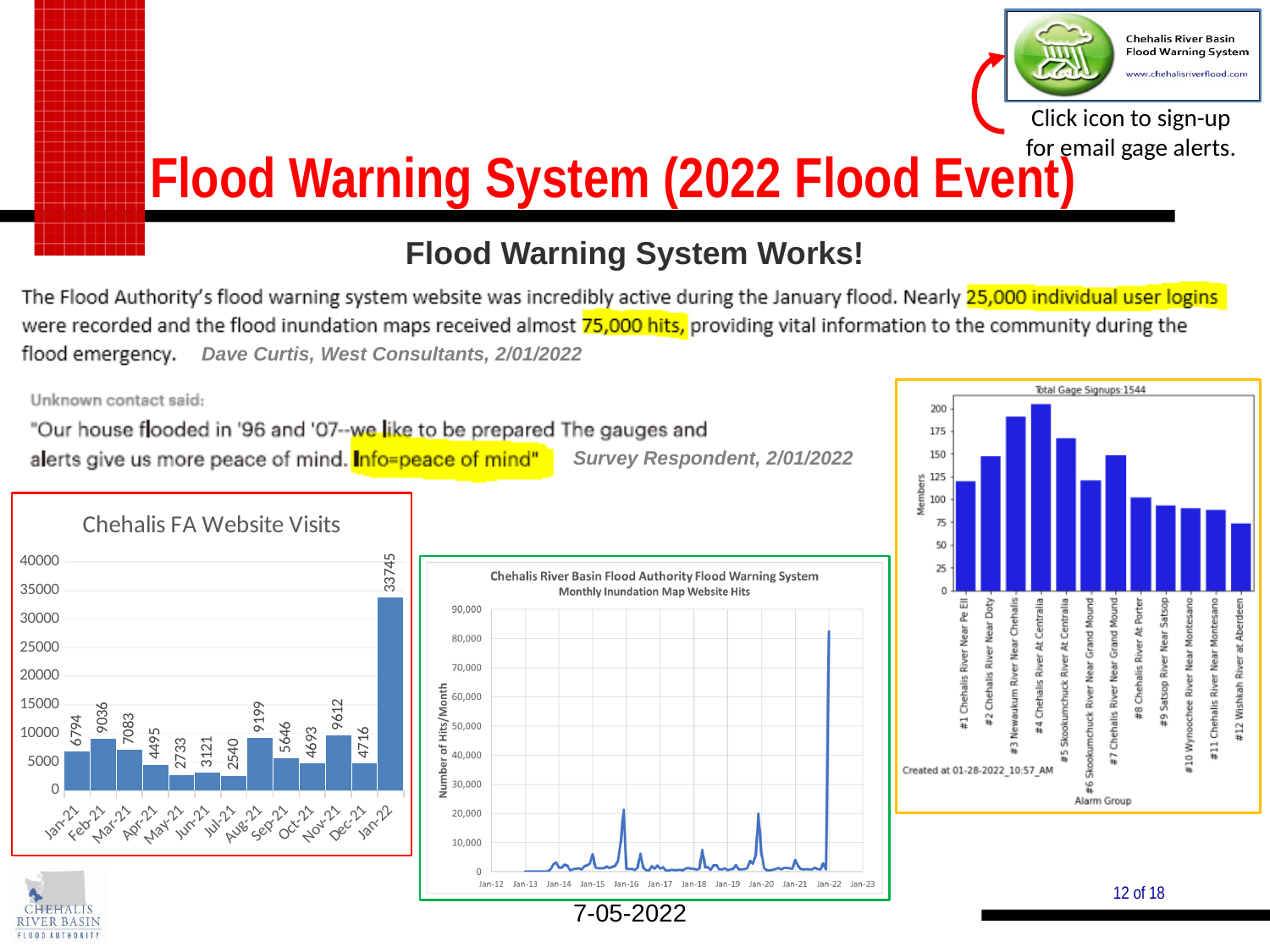
In the 'Chehalis FA Website Visits' chart, which month has the lowest number of visits? Jul-21 In the 'Monthly Inundation Map Website Hits' chart, is the peak value near Jan-22 greater or less than 80,000? greater In the 'Chehalis FA Website Visits' chart, which month has the highest number of visits? Jan-22 In the 'Chehalis FA Website Visits' chart, what is the value for Nov-21? 9612 In the 'Total Gage Signups' chart, which alarm group has the fewest members? #12 Wishkah River at Aberdeen In the 'Chehalis FA Website Visits' chart, what is the difference between the Feb-21 and Jan-21 values? 2242 In the 'Total Gage Signups' chart, is the value for #3 Newaukum River Near Chehalis greater or less than 175? greater How many months are shown in the 'Chehalis FA Website Visits' chart? 13 In the 'Chehalis FA Website Visits' chart, which is larger, the value for Aug-21 or the value for Mar-21? Aug-21 What kind of chart is the 'Monthly Inundation Map Website Hits' chart? Line chart In the 'Chehalis FA Website Visits' chart, what is the value for Jan-22? 33745 In the 'Total Gage Signups' chart, which alarm group has the most members? #4 Chehalis River At Centralia